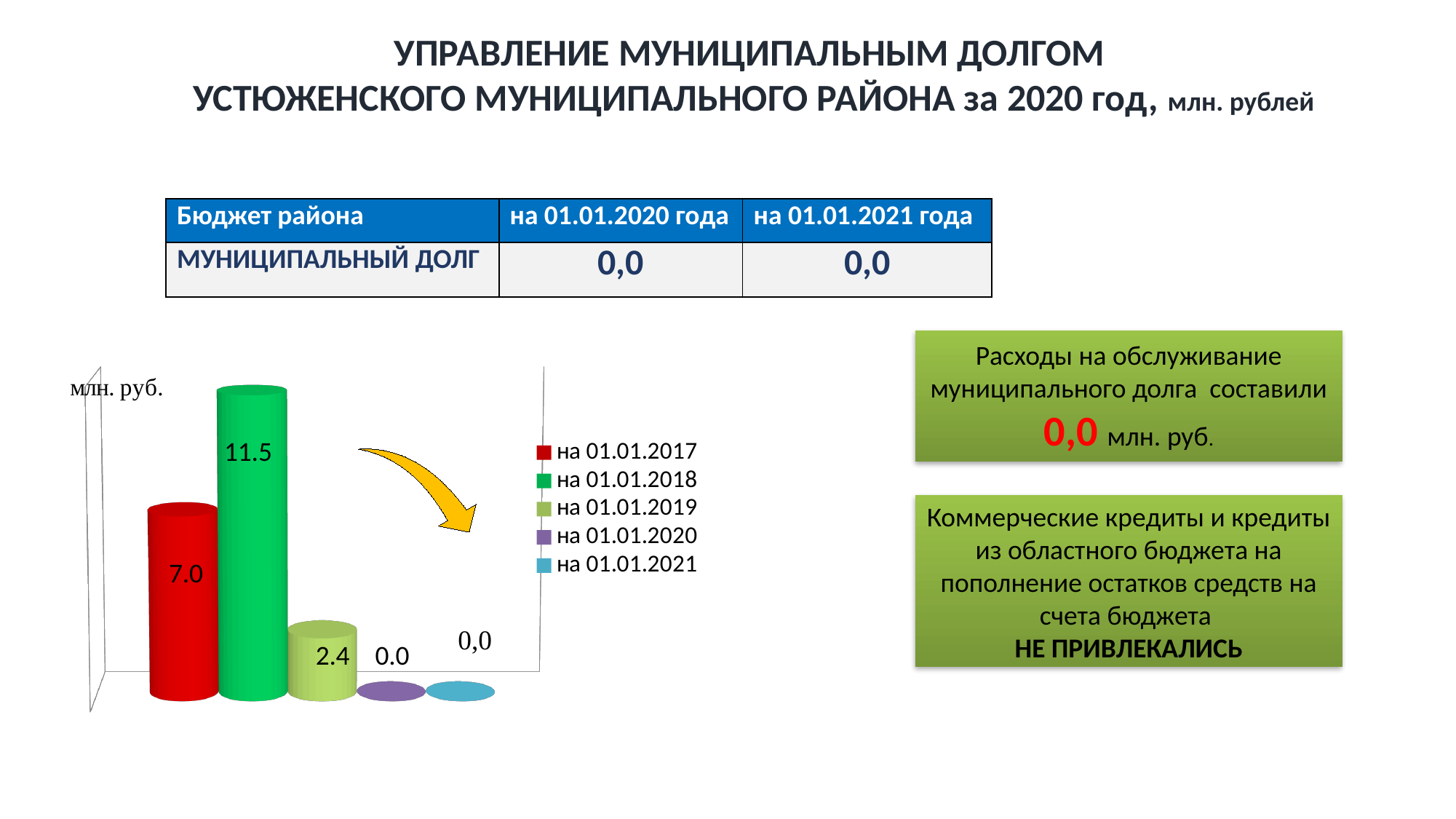
What kind of chart is shown on the slide? bar chart What is the value shown for на 01.01.2019? 2.4 Which date has the highest value in the chart? на 01.01.2018 Which is larger, the value for на 01.01.2017 or the value for на 01.01.2019? на 01.01.2017 What is the municipal debt value shown for на 01.01.2017? 7.0 What is the value shown for на 01.01.2020? 0.0 Do the values rise or fall from на 01.01.2018 to на 01.01.2021? fall What is the difference between the values for на 01.01.2017 and на 01.01.2019? 4.6 How many series does the chart legend list? 5 What is the difference between the values for на 01.01.2018 and на 01.01.2017? 4.5 What unit is labelled on the chart's vertical axis? млн. руб. What is the value shown for на 01.01.2018? 11.5